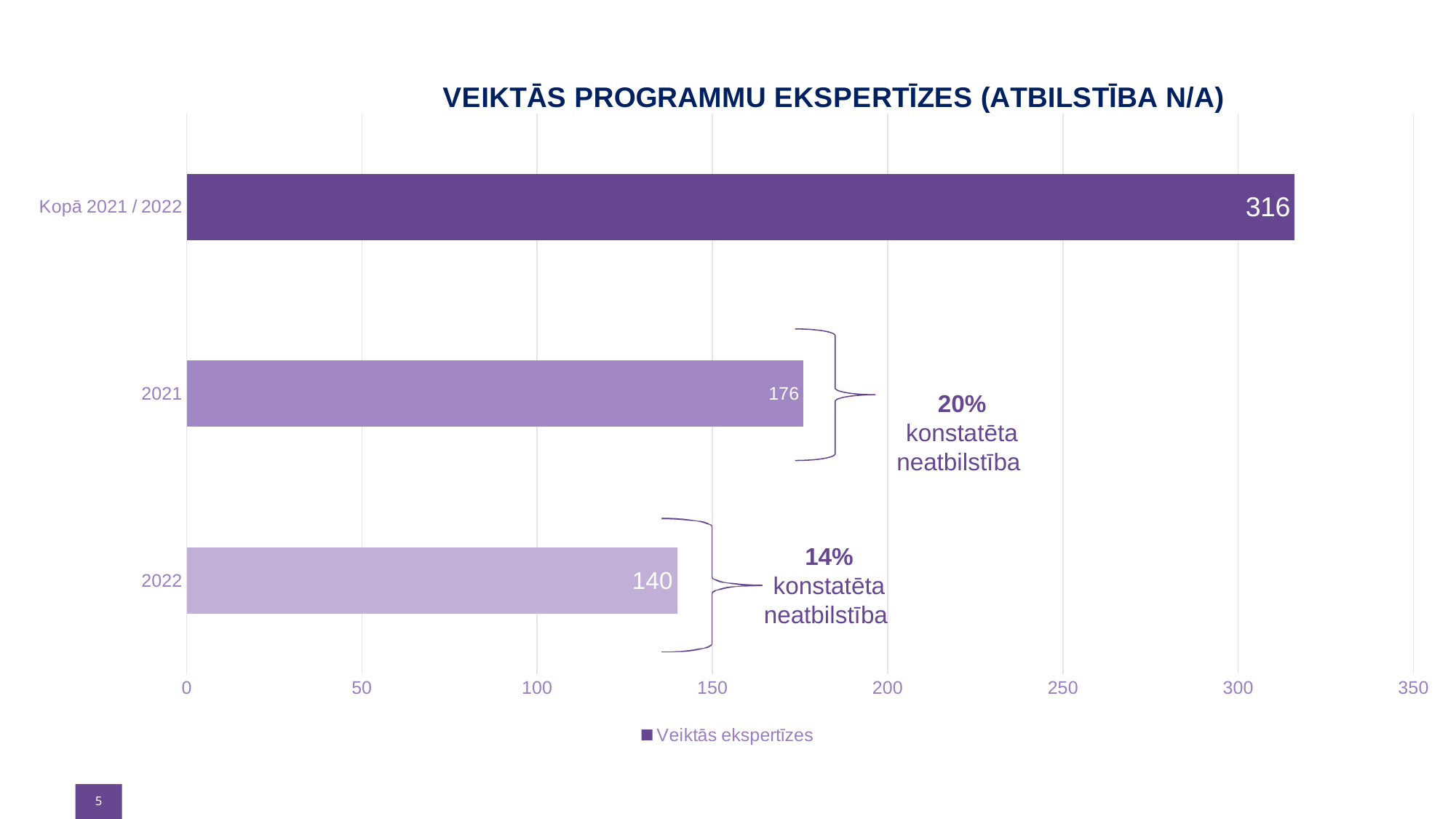
Which category has the highest value? Kopā 2021 / 2022 What is the difference between the values for 2021 and 2022? 36 What is the value for Kopā 2021 / 2022? 316 Is the value for 2021 greater or less than 150? greater Which is larger, the value for 2021 or the value for 2022? 2021 How many categories are shown on the chart? 3 Which category has the lowest value? 2022 What is the value for 2022? 140 What kind of chart is shown on the slide? bar chart What is the value for 2021? 176 How many series does the legend list? 1 What is the title of the chart? VEIKTĀS PROGRAMMU EKSPERTĪZES (ATBILSTĪBA N/A)